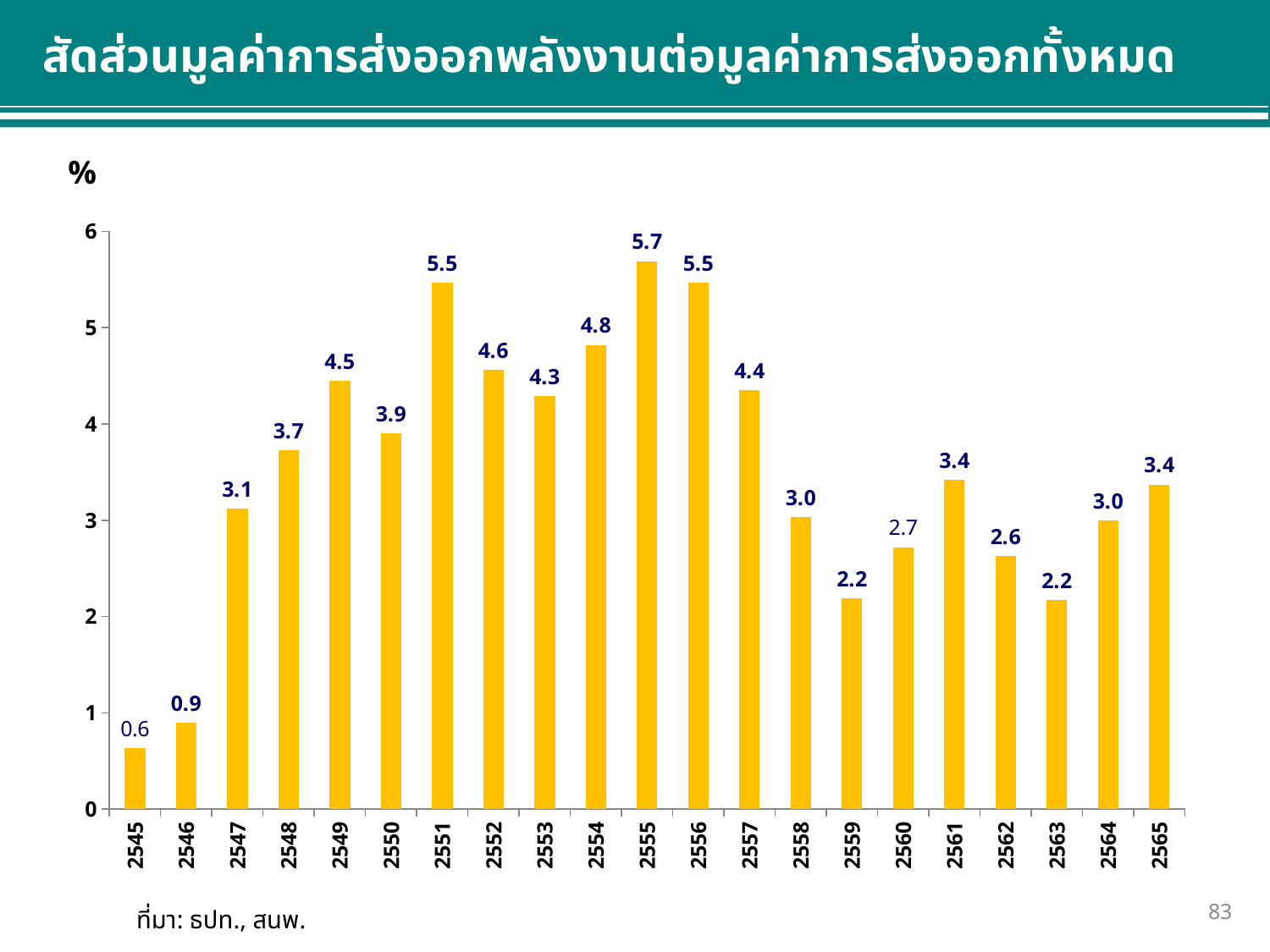
What is the difference between the values for 2555 and 2565? 2.3 Which is larger, the value for 2549 or the value for 2557? 2549 What is the value for 2555? 5.7 Do the values rise or fall from 2556 to 2559? fall What unit is shown on the y axis label? % Which year has the lowest value? 2545 What is the value for 2560? 2.7 What is the value for 2545? 0.6 Which year has the highest value? 2555 Is the value for 2551 greater or less than 5? greater How many years are shown on the x axis? 21 What kind of chart is this? bar chart